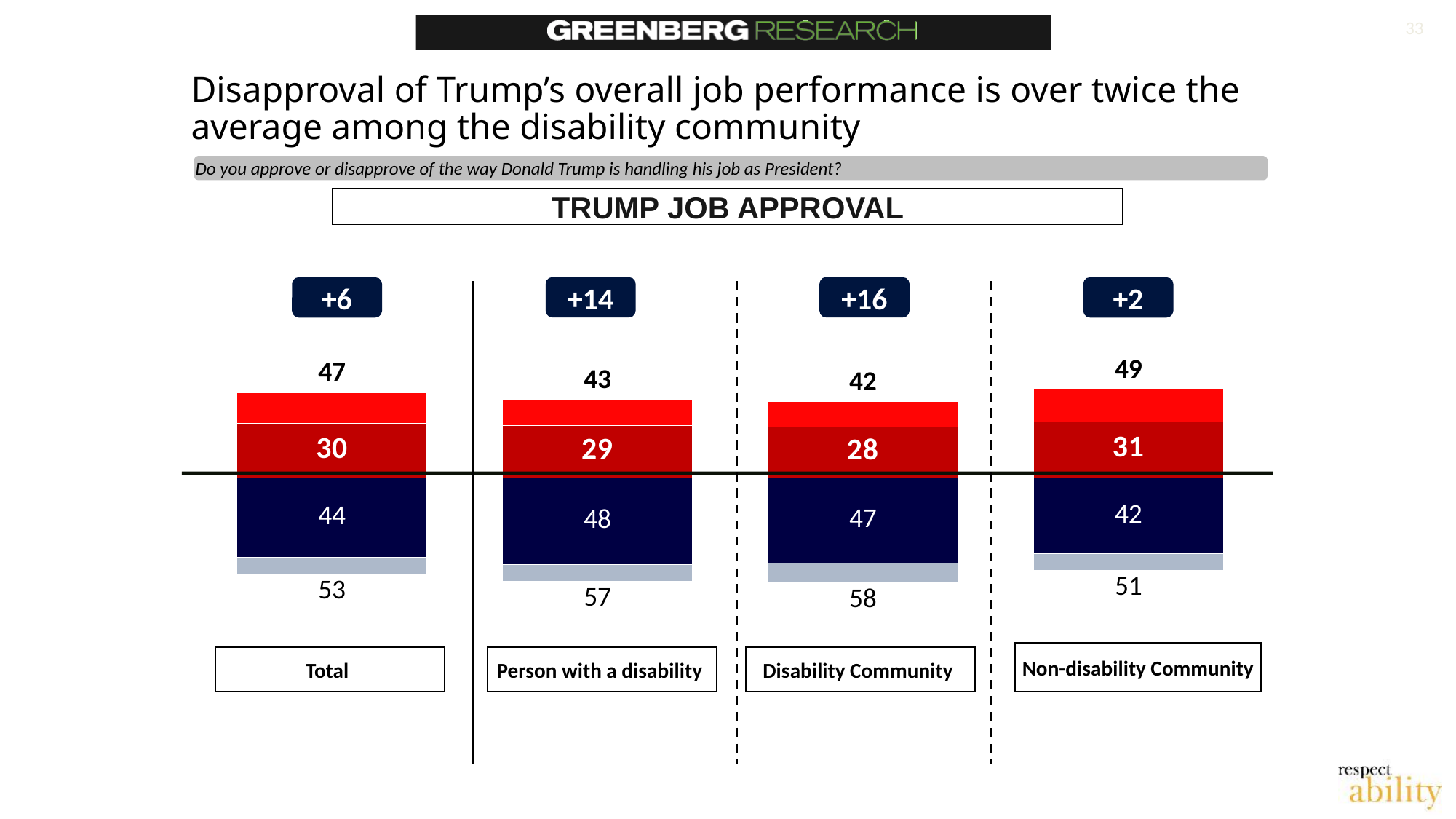
What is the net figure shown in the box above the Disability Community bar? +16 Which group has the lowest number printed above its bar? Disability Community What is the difference between the numbers printed below the bars for Disability Community and Non-disability Community? 7 What value is printed in the dark red segment of the Non-disability Community bar? 31 What value is printed in the navy segment of the Person with a disability bar? 48 How many groups are shown in the chart? 4 What kind of chart is shown on the slide? Bar chart Which group has the highest number printed below its bar? Disability Community What is the title shown in the box above the chart? TRUMP JOB APPROVAL What is the number printed below the bar for Disability Community? 58 What is the number printed above the bar for Total? 47 Which is larger: the number printed above the bar for Total or the number printed above the bar for Person with a disability? Total